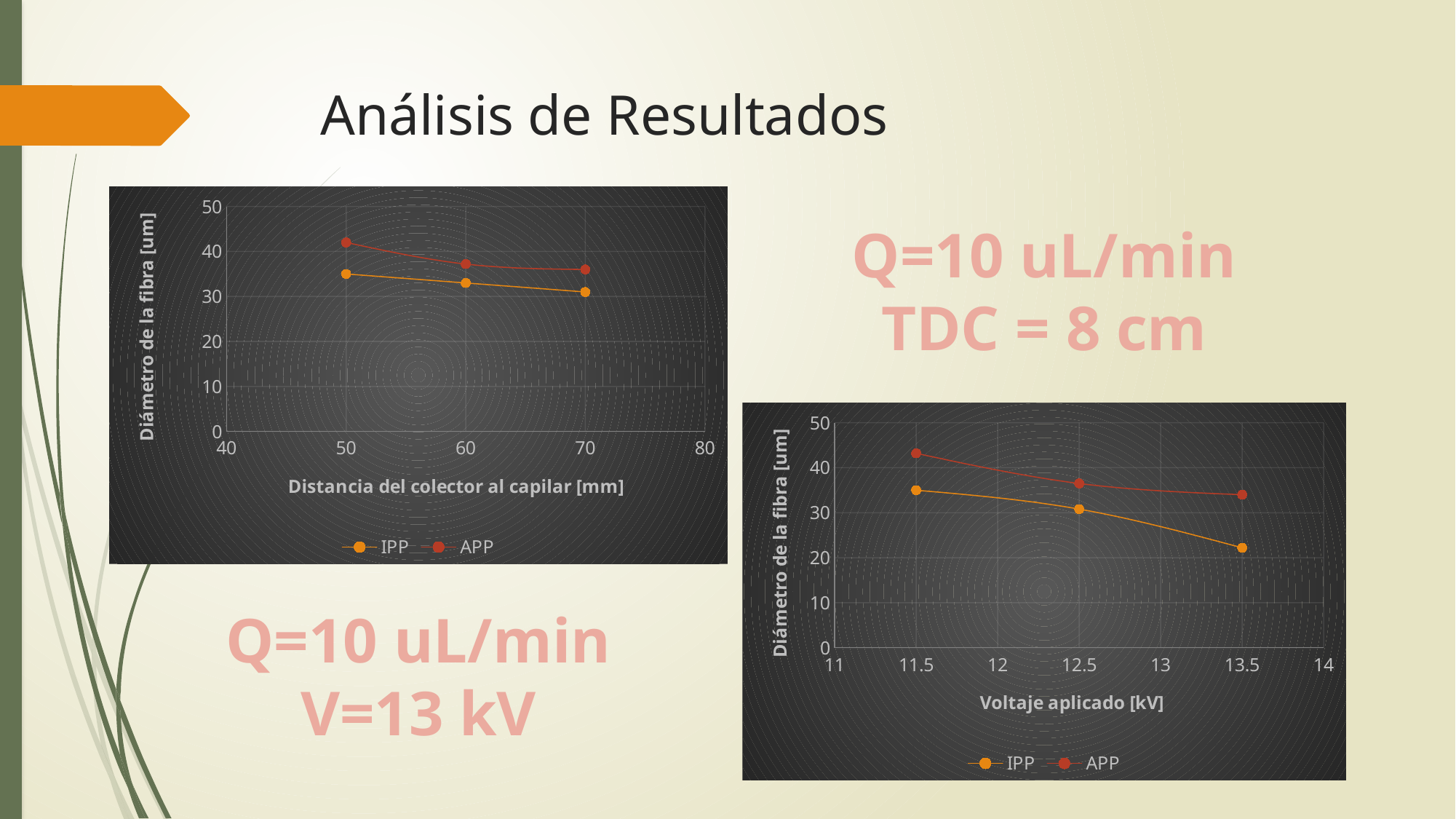
How many series does the legend of the right chart (Voltaje aplicado) list? 2 In the left chart (Distancia del colector al capilar), is the APP value at 50 mm greater or less than 40? greater In the left chart (Distancia del colector al capilar), do the IPP values rise or fall as the distance increases? fall How many data points does the IPP series have in the left chart (Distancia del colector al capilar)? 3 What is the x-axis title of the right chart? Voltaje aplicado [kV] In the left chart (Distancia del colector al capilar), is the IPP value at 70 mm greater or less than 40? less In the right chart (Voltaje aplicado), which series has the larger value at 13.5 kV, IPP or APP? APP In the right chart (Voltaje aplicado), do the APP values rise or fall as the voltage increases? fall What kind of chart is the left chart (Distancia del colector al capilar)? line chart In the right chart (Voltaje aplicado), is the APP value at 11.5 kV greater or less than 40? greater In the left chart (Distancia del colector al capilar), which series has the larger value at 60 mm, IPP or APP? APP